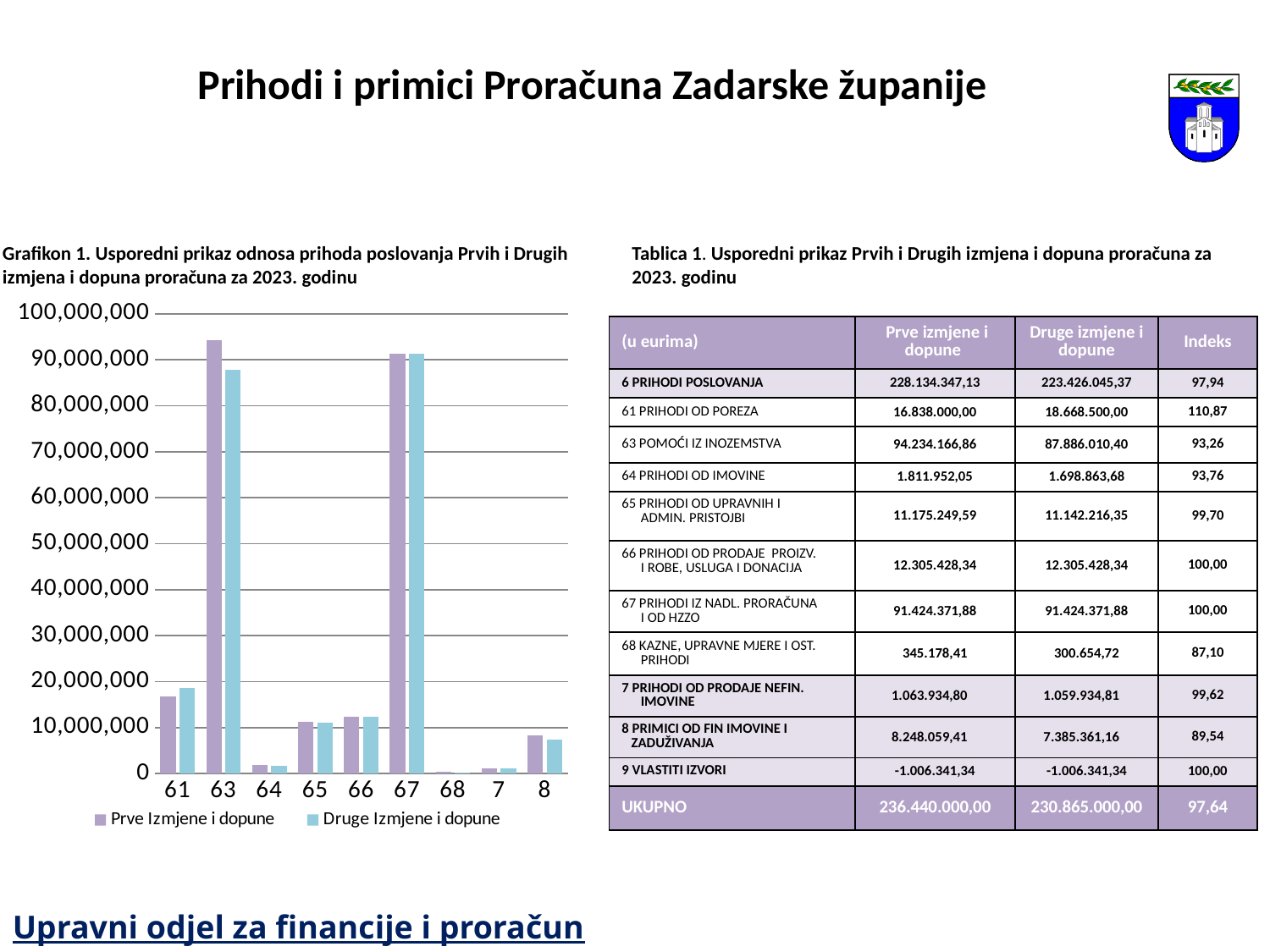
For category 61, which series has the larger value, Prve Izmjene i dopune or Druge Izmjene i dopune? Druge Izmjene i dopune Is the Prve Izmjene i dopune value for category 8 greater or less than 10,000,000? less Which category has the highest value for the Druge Izmjene i dopune series? 67 How many categories are shown on the x axis of the chart? 9 For category 63, which series has the larger value, Prve Izmjene i dopune or Druge Izmjene i dopune? Prve Izmjene i dopune How many series does the chart legend list? 2 Is the Druge Izmjene i dopune value for category 63 greater or less than 90,000,000? less Is the Prve Izmjene i dopune value for category 63 greater or less than 90,000,000? greater What kind of chart is shown on the slide? bar chart Which category has the lowest value for the Prve Izmjene i dopune series? 68 Which category has the highest value for the Prve Izmjene i dopune series? 63 What are the two series names listed in the chart legend? Prve Izmjene i dopune; Druge Izmjene i dopune